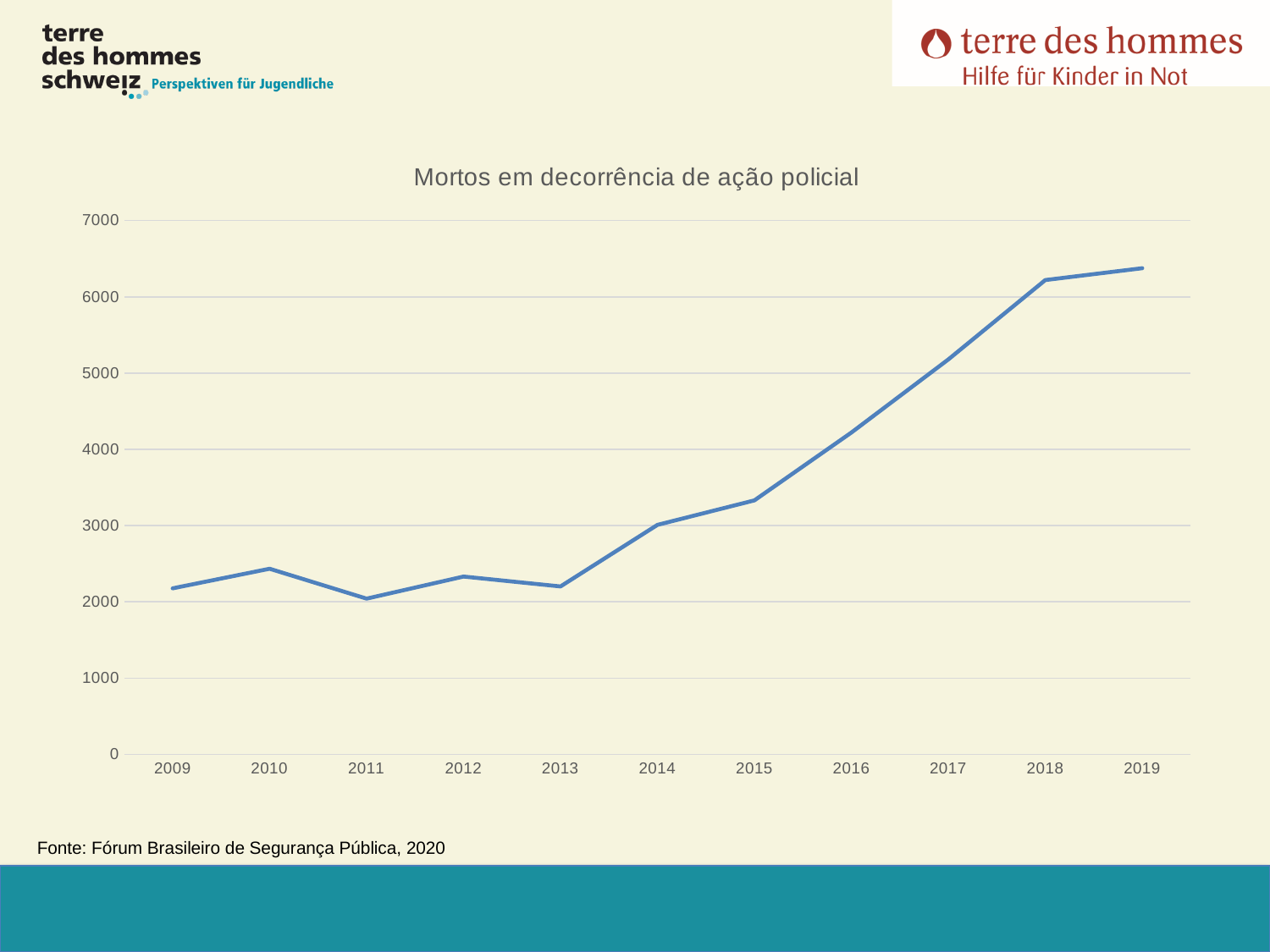
What is the title of the chart? Mortos em decorrência de ação policial Is the value for 2017 greater or less than 5000? greater Is the value for 2013 greater or less than 3000? less Is the value for 2009 greater or less than 3000? less Do the values generally rise or fall from 2013 to 2019? rise Which year has the lowest value on the chart? 2011 Which year has the larger value, 2015 or 2017? 2017 Which year has the highest value on the chart? 2019 How many years are plotted on the x axis of the chart? 11 What kind of chart is shown on the slide? line chart